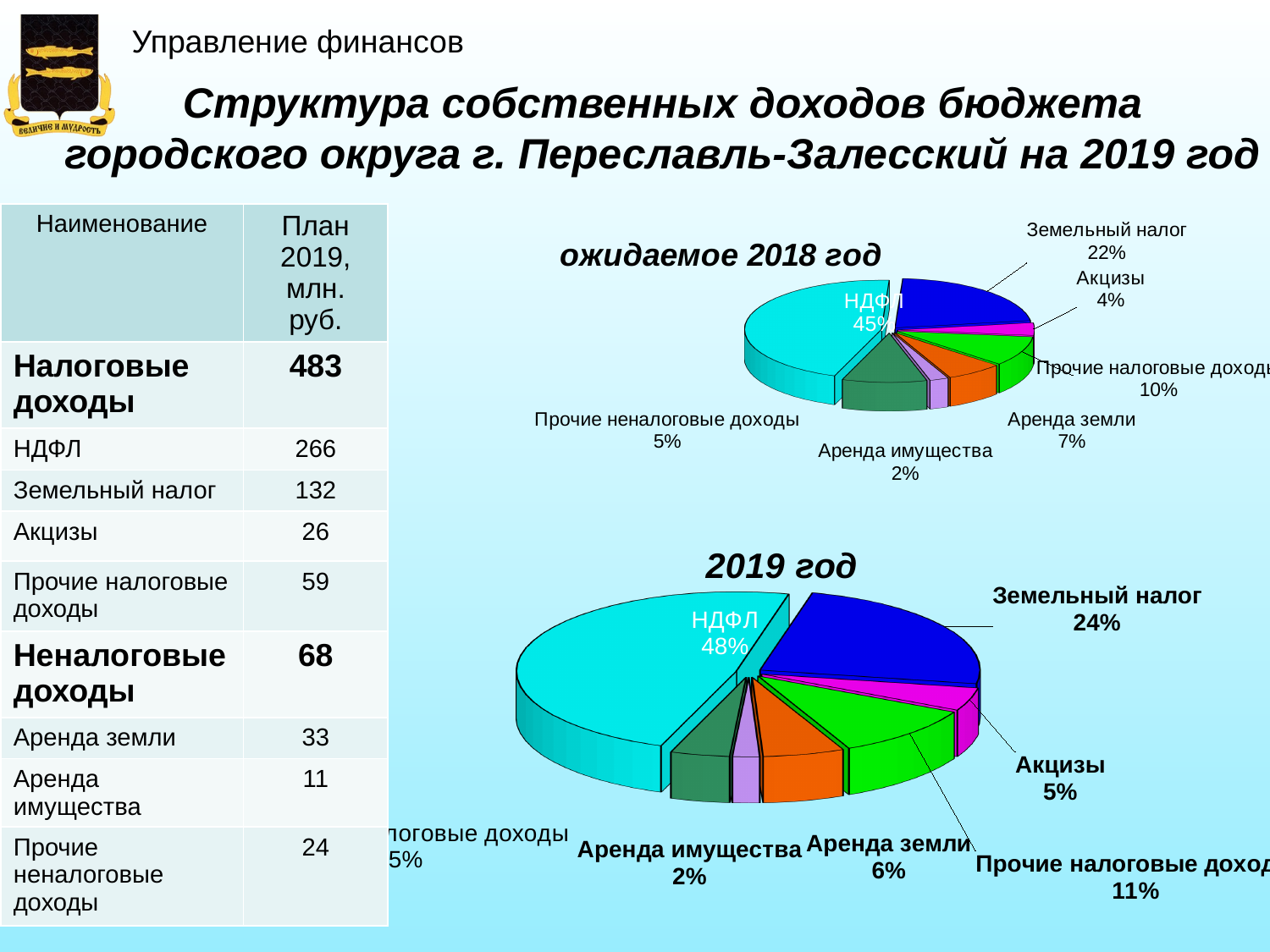
What is the difference between the Земельный налог share in the "2019 год" chart and in the "ожидаемое 2018 год" chart? 2% In the "2019 год" chart, what share does НДФЛ have? 48% In the "2019 год" chart, which category has the smallest slice? Аренда имущества In the "2019 год" chart, what share does Земельный налог have? 24% In the "ожидаемое 2018 год" chart, what share does Аренда земли have? 7% In the "ожидаемое 2018 год" chart, which category has the largest slice? НДФЛ In the "ожидаемое 2018 год" chart, what share does НДФЛ have? 45% In the "ожидаемое 2018 год" chart, which is larger: the share of Прочие налоговые доходы or the share of Аренда земли? Прочие налоговые доходы How many pie charts are shown on the slide? 2 What kind of chart is used for the "ожидаемое 2018 год" chart? pie chart In the "2019 год" chart, which is larger: the share of Акцизы or the share of Аренда земли? Аренда земли In the "2019 год" chart, what share does Прочие налоговые доходы have? 11%